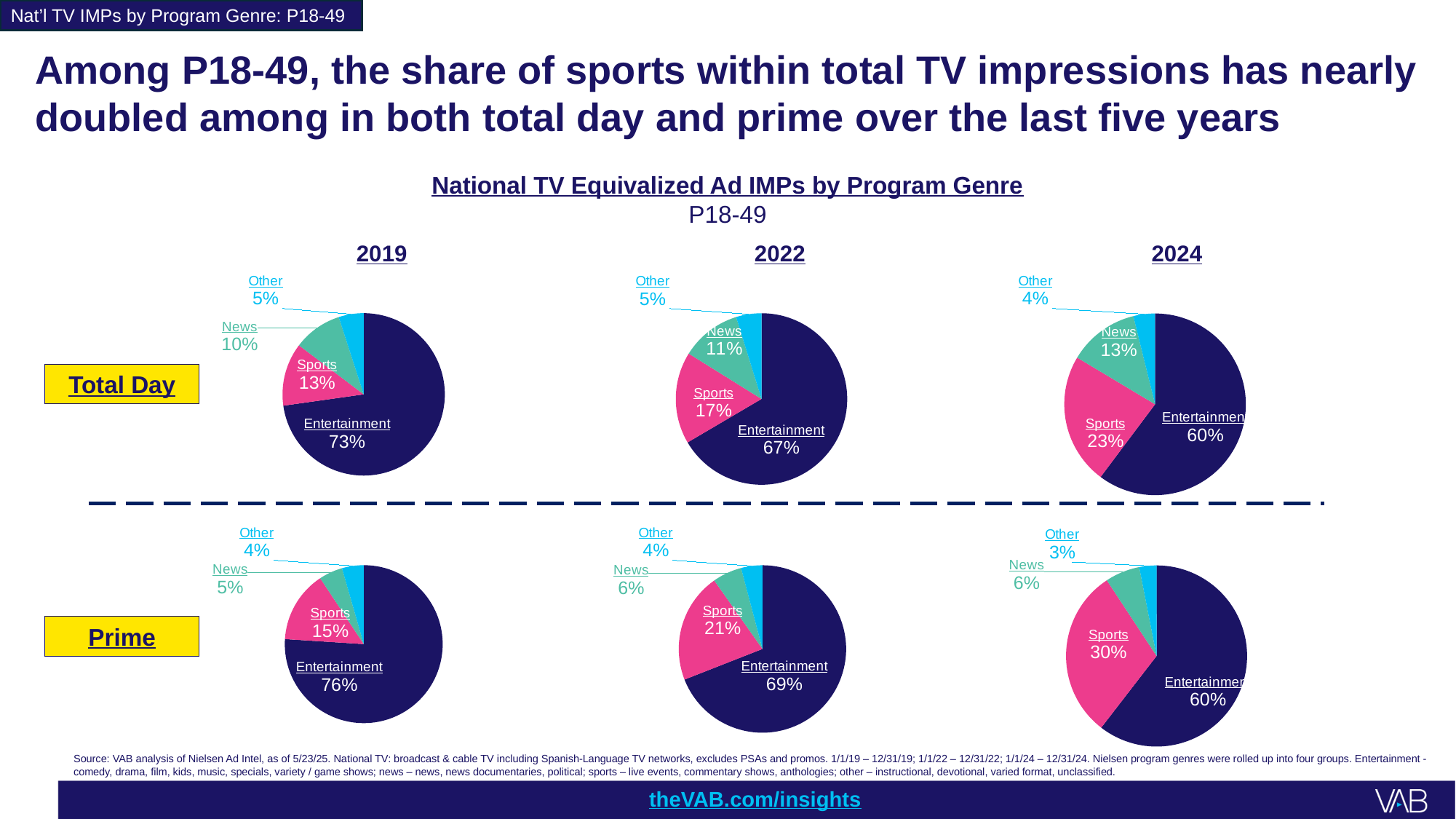
What type of chart is used to show the Prime 2022 data? Pie chart Across the Total Day pie charts from 2019 to 2024, does the Sports share rise or fall? Rise What is the title of the chart group on the slide? National TV Equivalized Ad IMPs by Program Genre Which is larger: the Sports share in the Total Day 2024 pie chart or the Sports share in the Prime 2022 pie chart? Total Day 2024 In the Total Day 2024 pie chart, what share of impressions is Entertainment? 60% In the Prime 2019 pie chart, which genre has the smallest share? Other In the Total Day 2022 pie chart, which genre has the largest share? Entertainment In the Prime 2022 pie chart, what share of impressions is News? 6% What is the difference between the Sports share in the Prime 2024 pie chart and the Sports share in the Prime 2019 pie chart? 15 percentage points In the Total Day 2019 pie chart, what share of impressions is Sports? 13% How many slices does the Total Day 2019 pie chart have? 4 In the Prime 2024 pie chart, what share of impressions is Sports? 30%